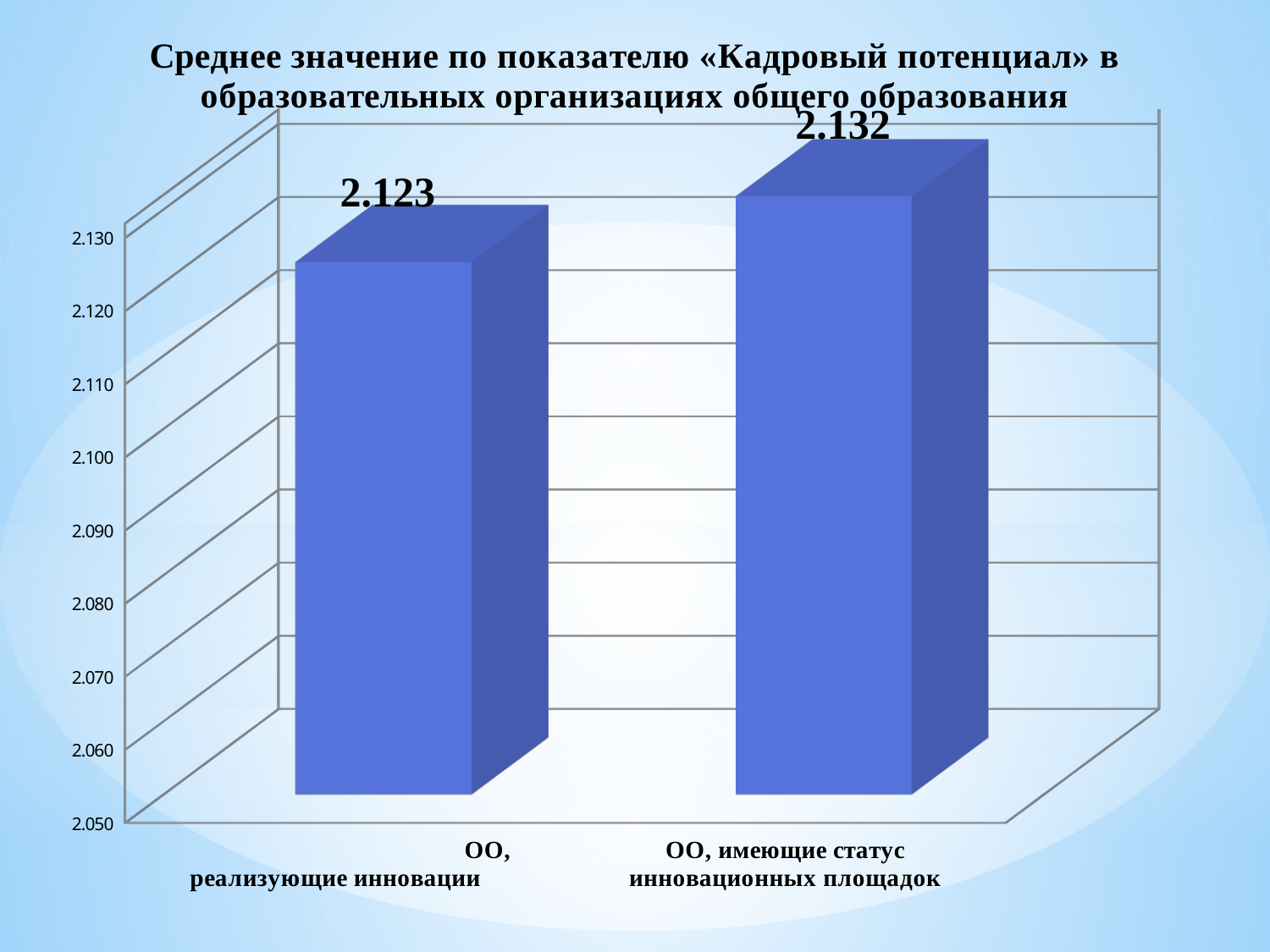
What kind of chart is shown on the slide? bar chart Which is larger: the value for «ОО, реализующие инновации» or for «ОО, имеющие статус инновационных площадок»? ОО, имеющие статус инновационных площадок Which category has the lowest value? ОО, реализующие инновации How many categories are shown in the chart? 2 What is the value for «ОО, имеющие статус инновационных площадок»? 2.132 Is the value for «ОО, реализующие инновации» greater or less than 2.100? greater Which category has the highest value? ОО, имеющие статус инновационных площадок What is the lowest value shown on the vertical axis? 2.050 What is the difference between the values for «ОО, имеющие статус инновационных площадок» and «ОО, реализующие инновации»? 0.009 Is the value for «ОО, имеющие статус инновационных площадок» greater or less than 2.130? greater What is the title of the chart? Среднее значение по показателю «Кадровый потенциал» в образовательных организациях общего образования What is the value for «ОО, реализующие инновации»? 2.123